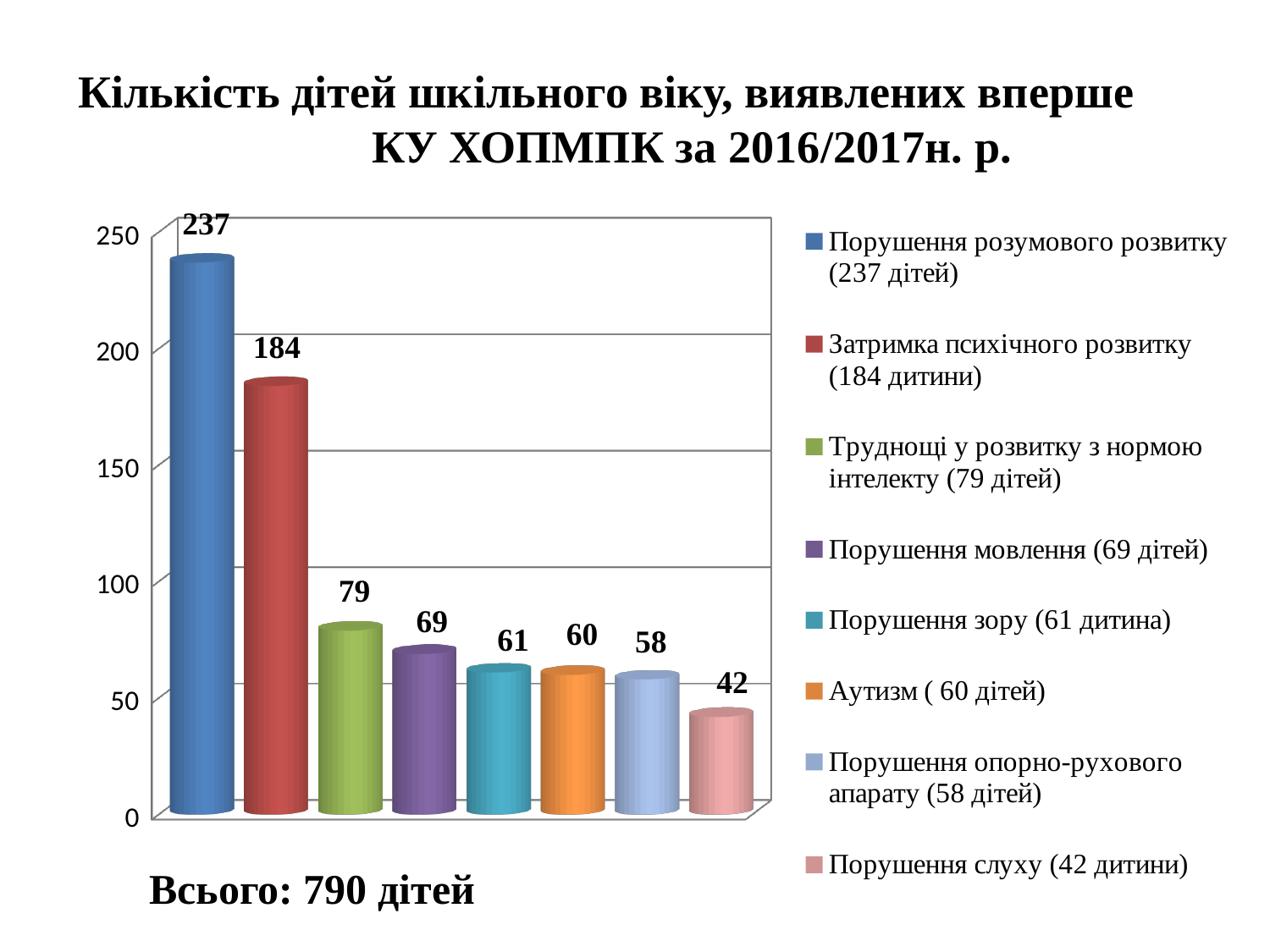
Which is larger, the value for Труднощі у розвитку з нормою інтелекту or the value for Порушення мовлення? Труднощі у розвитку з нормою інтелекту Do the values rise or fall from left to right along the x axis? fall Which category has the highest value? Порушення розумового розвитку How many categories are plotted in the chart? 8 Which category has the lowest value? Порушення слуху What is the value for Порушення слуху? 42 Is the value for Порушення зору greater or less than 100? less What is the value for Затримка психічного розвитку? 184 What is the value for Аутизм? 60 What kind of chart is shown on the slide? bar chart What is the value for Порушення розумового розвитку? 237 What is the difference between the values for Порушення розумового розвитку and Затримка психічного розвитку? 53